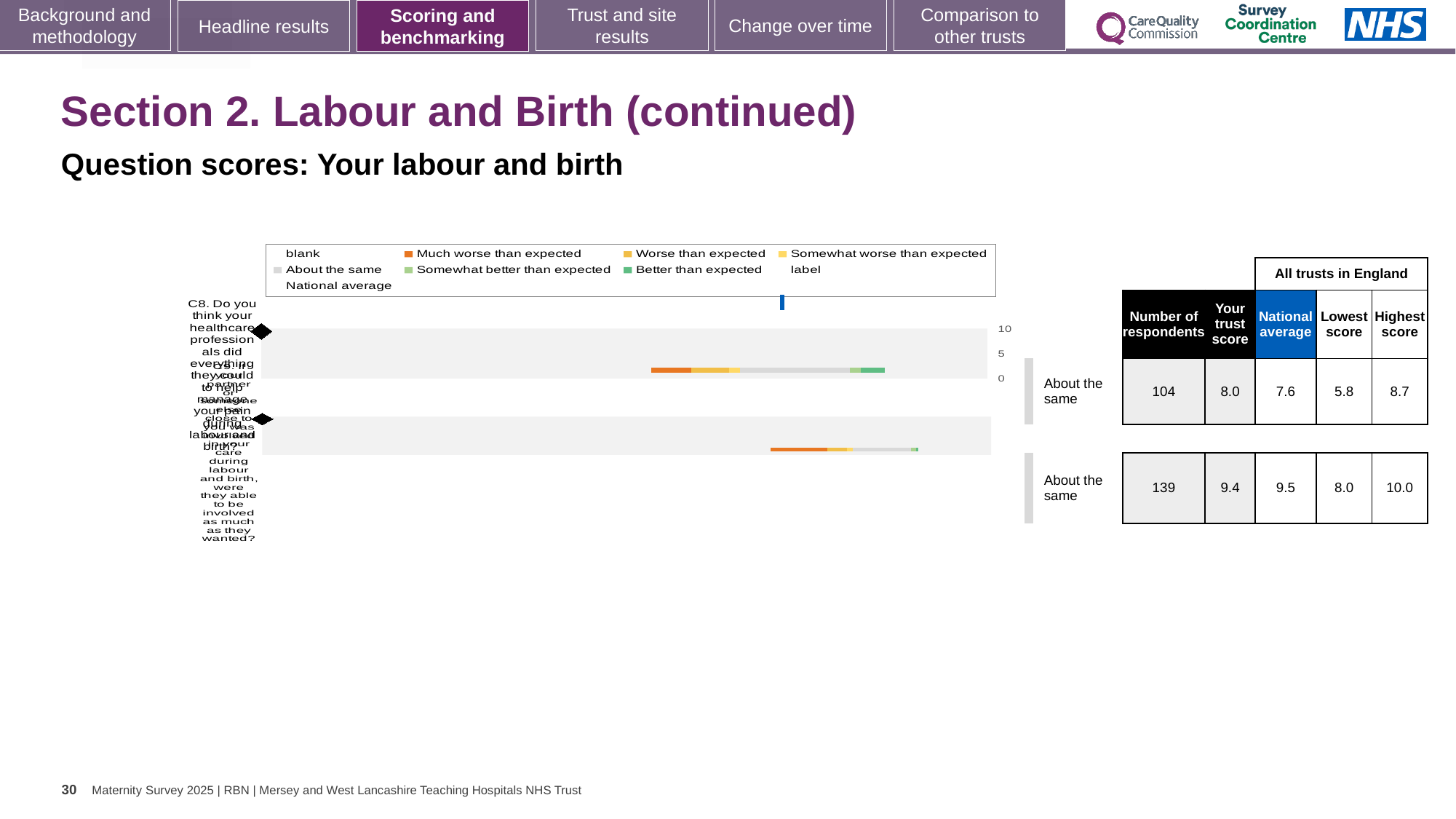
What is the national average for question C8 (the top row)? 7.6 What is the highest score among all trusts in England for the second question (the bottom row)? 10.0 How many survey questions (rows) are plotted in the chart? 2 What is the lowest score among all trusts in England for the second question (the bottom row)? 8.0 What kind of chart is shown on the slide? bar chart For question C8 (the top row), which is larger: the trust score or the national average? the trust score In the table next to the chart, what is the number of respondents for question C8 (the top row)? 104 What colour does the legend use for 'Much worse than expected'? orange What benchmark category is shown for both questions on the slide? About the same What is the trust score for question C8 (the top row)? 8.0 For question C8 (the top row), what is the difference between the highest score and the lowest score? 2.9 What is the difference in the number of respondents between the second question (139) and question C8 (104)? 35